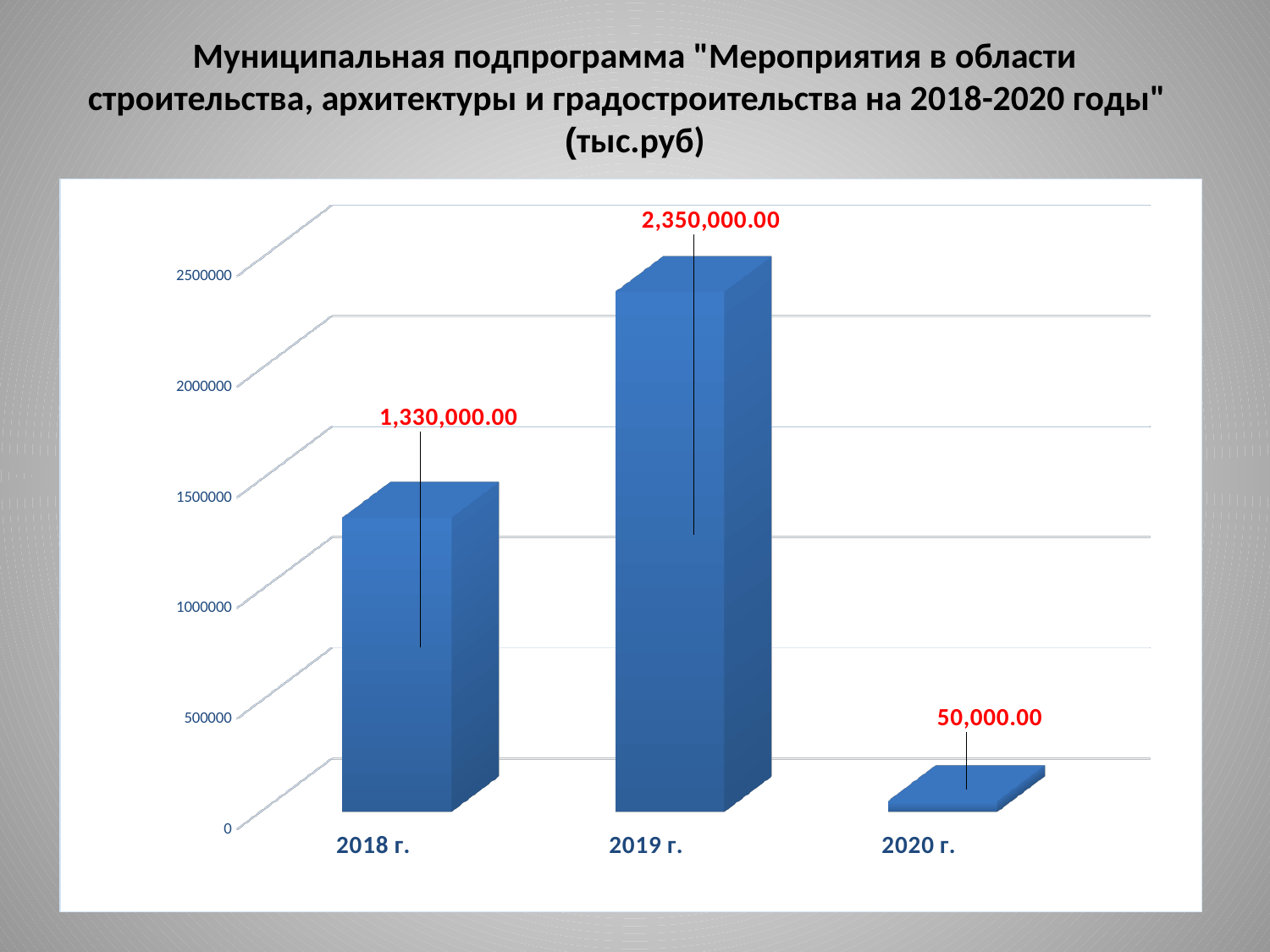
What is the value for 2020 г.? 50,000.00 Which is larger, the value for 2018 г. or the value for 2019 г.? 2019 г. What is the difference between the values for 2019 г. and 2018 г.? 1,020,000.00 Which year has the highest value? 2019 г. Which year has the lowest value? 2020 г. What unit is given in the chart title? тыс.руб What is the value for 2019 г.? 2,350,000.00 What is the difference between the values for 2018 г. and 2020 г.? 1,280,000.00 Is the value for 2018 г. greater or less than 1500000? less What is the value for 2018 г.? 1,330,000.00 What kind of chart is shown on the slide? bar chart How many years are shown on the chart? 3